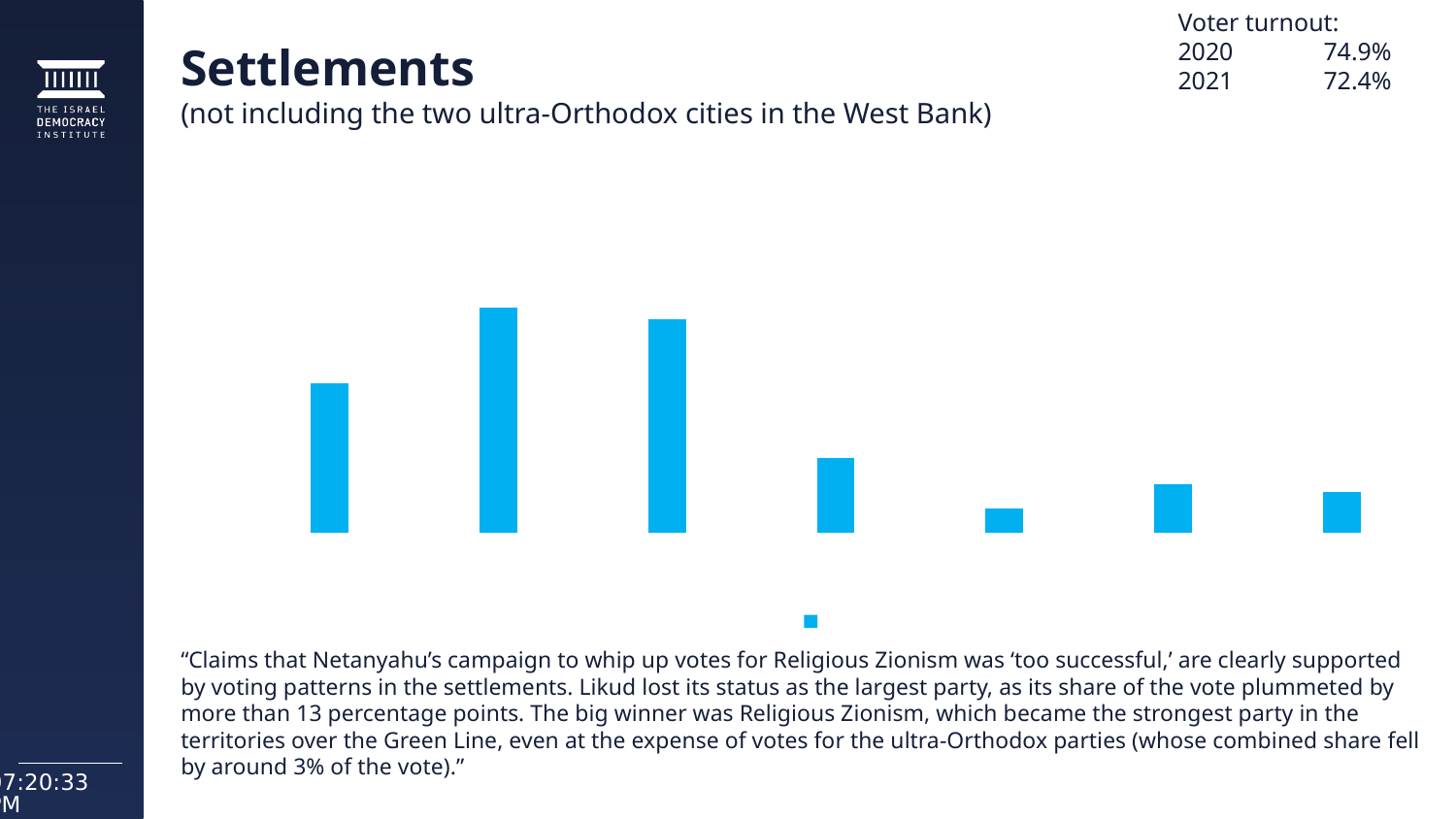
How many bars are plotted in the chart? 7 What colour are the bars in the chart? light blue Counting from the left, which bar in the chart is the tallest? the second bar Does the chart display data labels or axis values for the bars? No Which is taller, the first bar from the left or the fourth bar from the left? the first bar Counting from the left, which bar in the chart is the shortest? the fifth bar What kind of chart is shown on the slide? bar chart Which is taller, the fourth bar from the left or the seventh bar from the left? the fourth bar Which is taller, the second bar from the left or the third bar from the left? the second bar